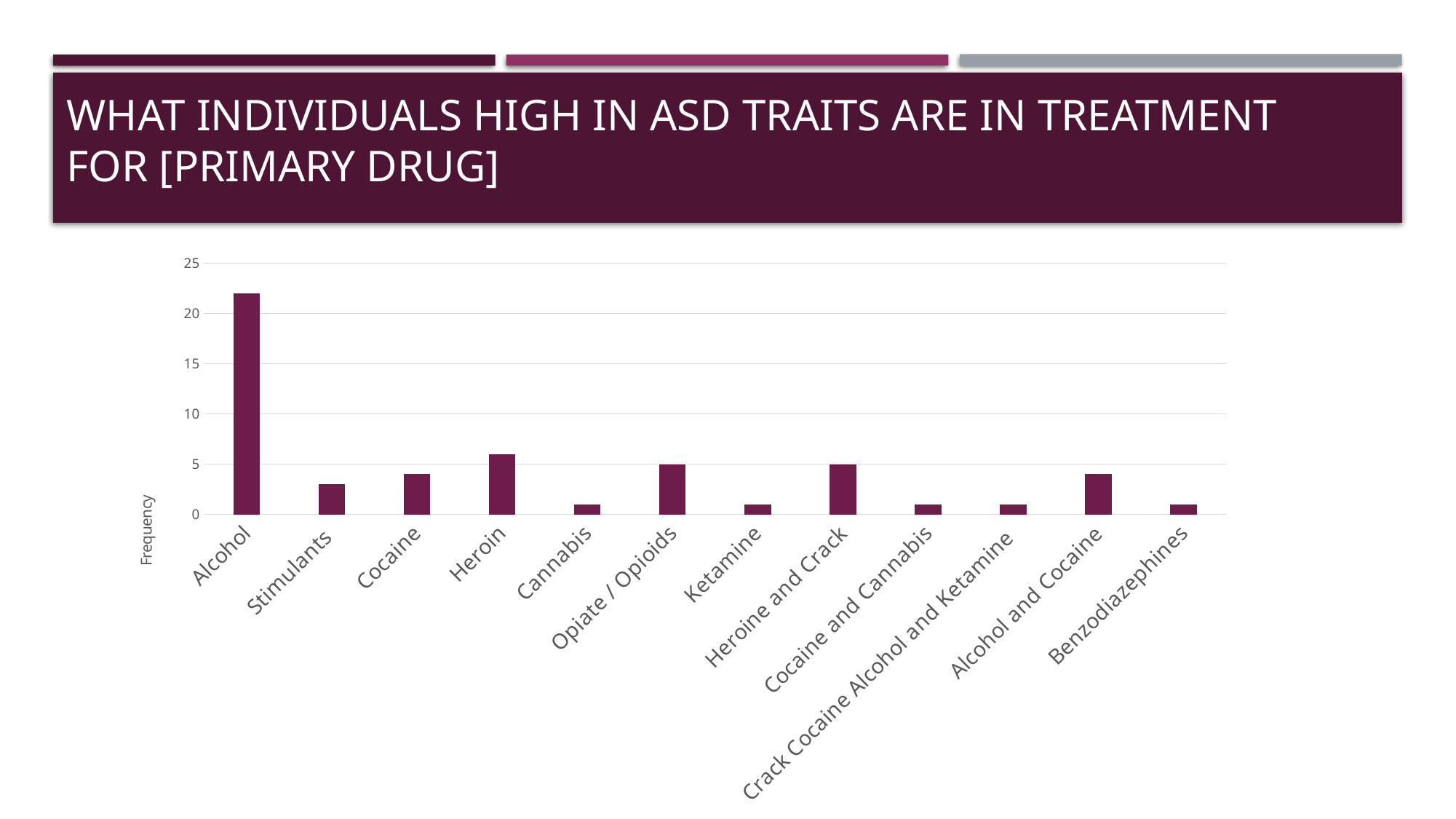
Is the frequency for Stimulants greater or less than 5? less What is the frequency for Heroine and Crack? 5 What is the frequency for Opiate / Opioids? 5 How many drug categories are shown on the x axis of the chart? 12 Is the frequency for Alcohol greater or less than 20? greater Which has a higher frequency, Heroin or Stimulants? Heroin Is the frequency for Heroin greater or less than 5? greater What is the label on the vertical axis of the chart? Frequency What kind of chart is shown on the slide? bar chart Which has a higher frequency, Alcohol or Heroin? Alcohol Which primary drug category has the highest frequency? Alcohol